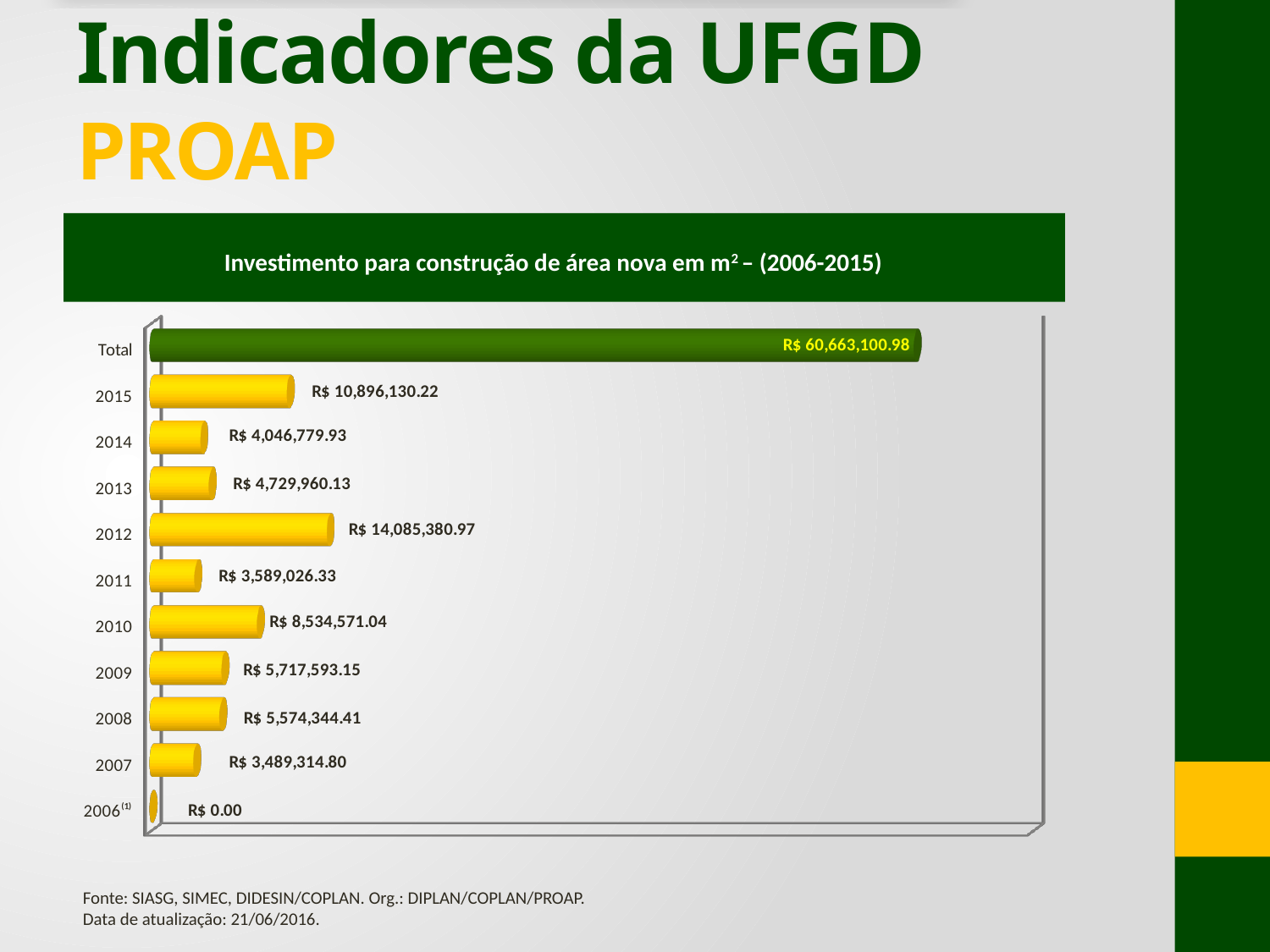
How many years (excluding the Total bar) are shown in the chart? 10 What is the value shown for 2012? R$ 14,085,380.97 What is the value shown for the Total bar? R$ 60,663,100.98 Which is larger, the value for 2013 or the value for 2014? 2013 Excluding the Total bar, which year has the highest investment value? 2012 What is the value shown for 2010? R$ 8,534,571.04 What is the difference between the values for 2015 and 2014? R$ 6,849,350.29 What is the title of the chart? Investimento para construção de área nova em m² – (2006-2015) What kind of chart is shown on the slide? Bar chart What is the value shown for 2007? R$ 3,489,314.80 What is the difference between the values for 2012 and 2015? R$ 3,189,250.75 Which year has the lowest investment value? 2006